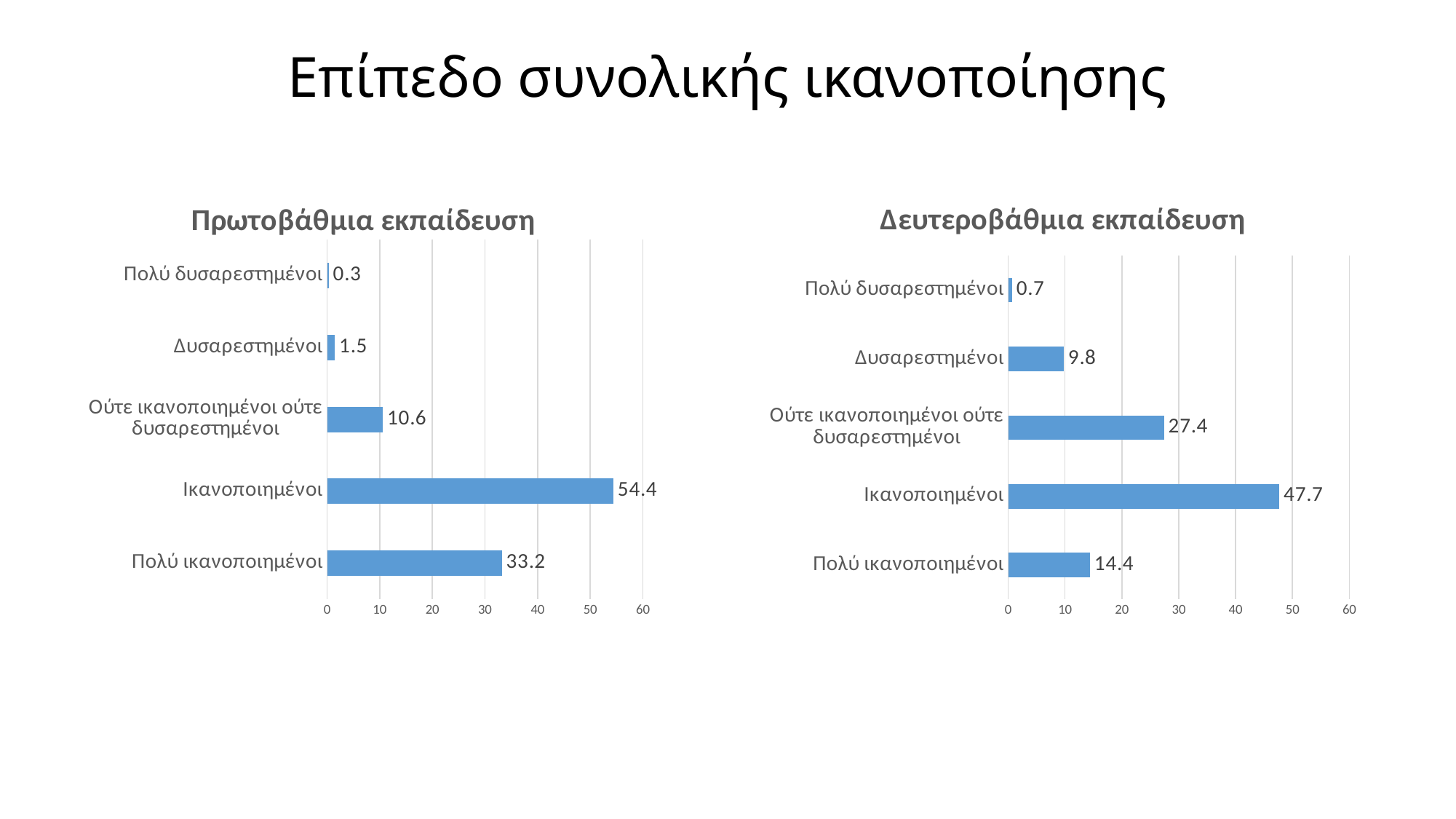
In the 'Δευτεροβάθμια εκπαίδευση' chart, what is the value for 'Ούτε ικανοποιημένοι ούτε δυσαρεστημένοι'? 27.4 What is the title of the slide? Επίπεδο συνολικής ικανοποίησης What kind of chart is the 'Δευτεροβάθμια εκπαίδευση' chart? Bar chart In the 'Πρωτοβάθμια εκπαίδευση' chart, which category has the highest value? Ικανοποιημένοι How many categories are shown in the 'Πρωτοβάθμια εκπαίδευση' chart? 5 In the 'Πρωτοβάθμια εκπαίδευση' chart, what is the difference between 'Ικανοποιημένοι' and 'Πολύ ικανοποιημένοι'? 21.2 In the 'Δευτεροβάθμια εκπαίδευση' chart, is the value for 'Ικανοποιημένοι' greater or less than 40? greater In the 'Δευτεροβάθμια εκπαίδευση' chart, what is the difference between 'Ικανοποιημένοι' and 'Πολύ ικανοποιημένοι'? 33.3 In the 'Πρωτοβάθμια εκπαίδευση' chart, what is the value for 'Ικανοποιημένοι'? 54.4 In the 'Πρωτοβάθμια εκπαίδευση' chart, what is the value for 'Δυσαρεστημένοι'? 1.5 In the 'Δευτεροβάθμια εκπαίδευση' chart, which category has the lowest value? Πολύ δυσαρεστημένοι Which is larger: 'Πολύ ικανοποιημένοι' in the 'Πρωτοβάθμια εκπαίδευση' chart or 'Πολύ ικανοποιημένοι' in the 'Δευτεροβάθμια εκπαίδευση' chart? Πρωτοβάθμια εκπαίδευση